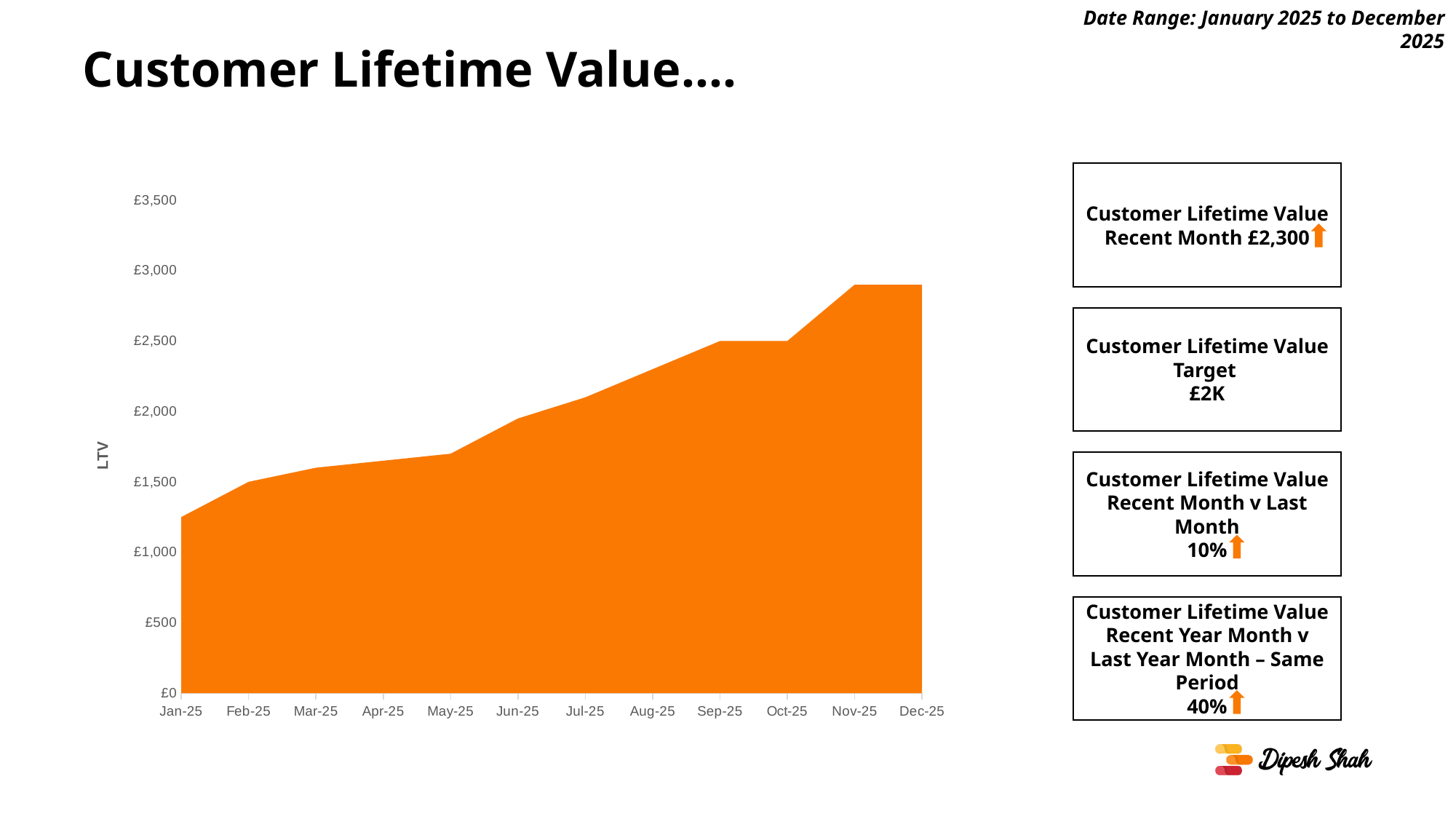
Which month has the larger LTV value, Sep-25 or Mar-25? Sep-25 Is the LTV value for Jan-25 greater or less than £1,500? less Which month has the larger LTV value, Dec-25 or Jan-25? Dec-25 How many months are plotted along the x axis of the chart? 12 What is the label on the vertical axis of the chart? LTV What kind of chart is shown on the slide? area chart Which month has the lowest LTV value in the chart? Jan-25 Is the LTV value for Jan-25 greater or less than £1,000? greater Do the LTV values generally rise or fall from Jan-25 to Dec-25? rise Is the LTV value for Aug-25 greater or less than £2,000? greater